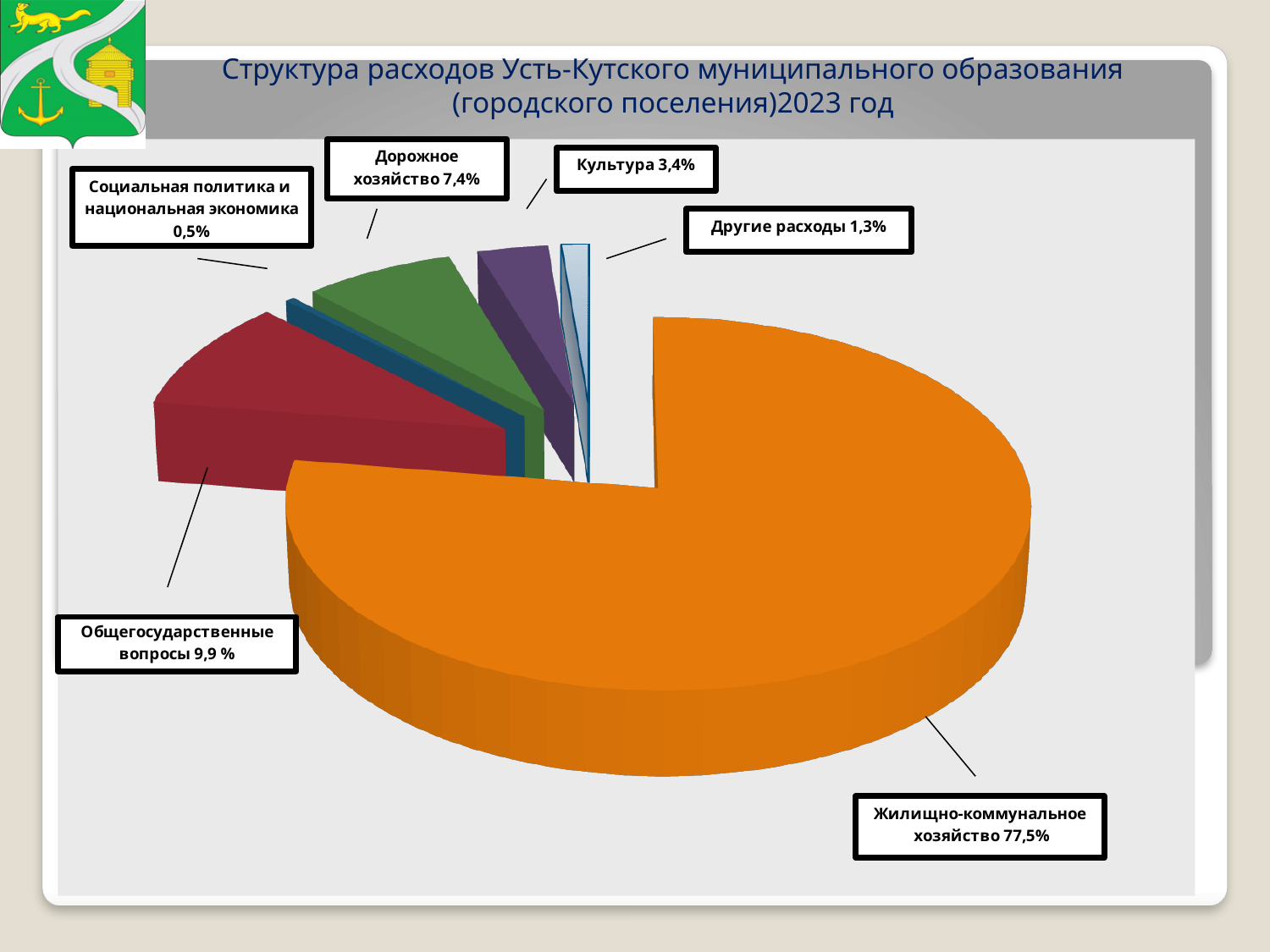
Which category has the largest share of expenditures? Жилищно-коммунальное хозяйство What is the share of Жилищно-коммунальное хозяйство in the pie chart? 77,5% What is the share of Другие расходы? 1,3% How many categories are shown in the pie chart? 6 What is the share of Социальная политика и национальная экономика? 0,5% Which is larger: the share of Дорожное хозяйство or the share of Культура? Дорожное хозяйство What is the share of Общегосударственные вопросы? 9,9 % What is the difference between the shares of Общегосударственные вопросы and Дорожное хозяйство? 2,5% What is the share of Культура? 3,4% What is the share of Дорожное хозяйство? 7,4% Which category has the smallest share of expenditures? Социальная политика и национальная экономика What kind of chart is shown on the slide? Pie chart